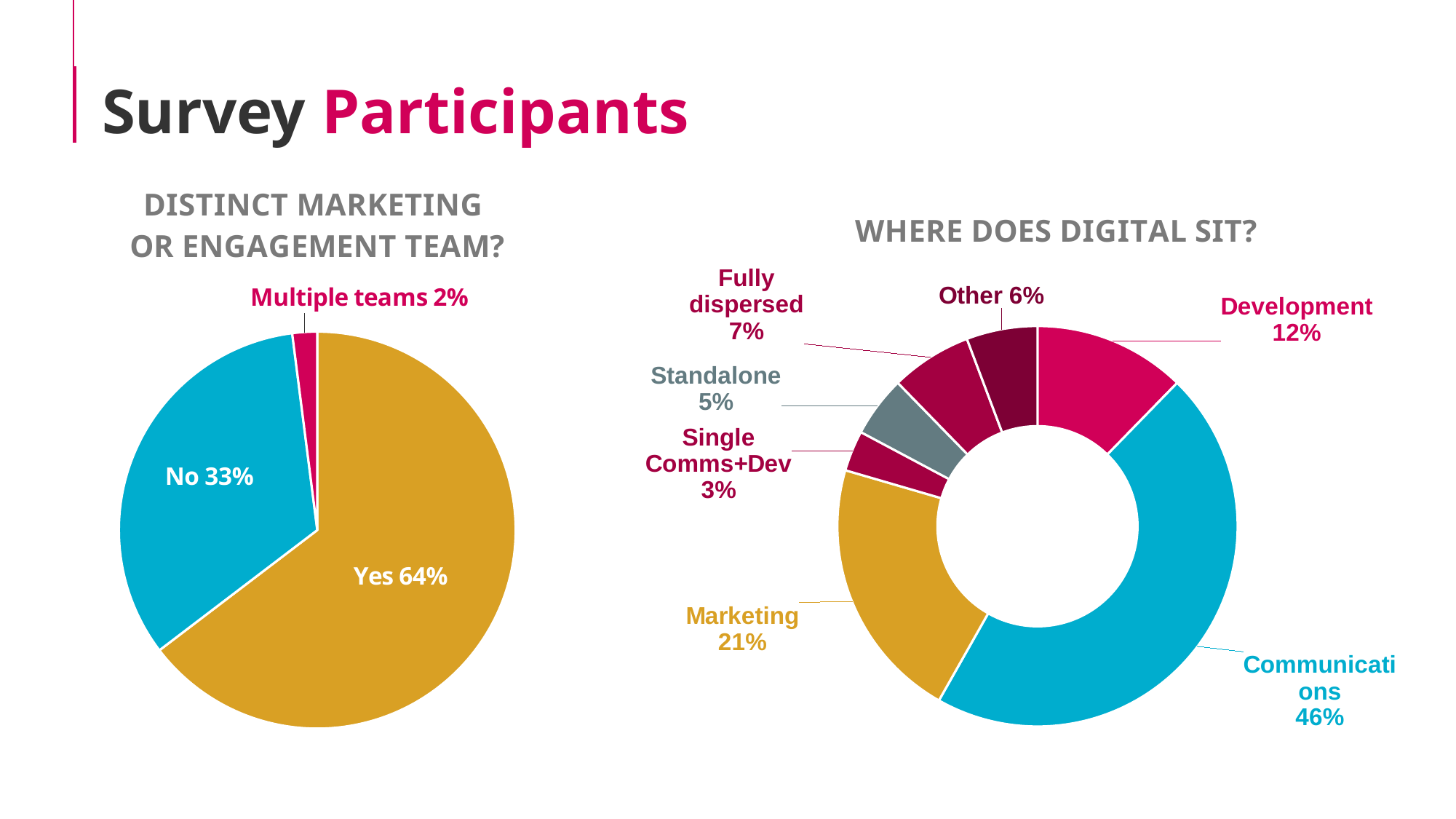
What kind of chart is 'Distinct Marketing or Engagement Team?'? Pie chart In the 'Where Does Digital Sit?' chart, how many categories are shown? 7 In the 'Distinct Marketing or Engagement Team?' chart, what is the difference between the Yes and No shares? 31% In the 'Where Does Digital Sit?' chart, which category has the largest share? Communications In the 'Distinct Marketing or Engagement Team?' chart, what share of participants answered No? 33% In the 'Distinct Marketing or Engagement Team?' chart, how many categories are shown? 3 In the 'Where Does Digital Sit?' chart, which category has the smallest share? Single Comms+Dev In the 'Where Does Digital Sit?' chart, which is larger: Development or Fully dispersed? Development In the 'Distinct Marketing or Engagement Team?' chart, what share of participants answered Yes? 64% In the 'Where Does Digital Sit?' chart, what share is Marketing? 21% In the 'Distinct Marketing or Engagement Team?' chart, which category has the smallest slice? Multiple teams In the 'Where Does Digital Sit?' chart, what share is Communications? 46%